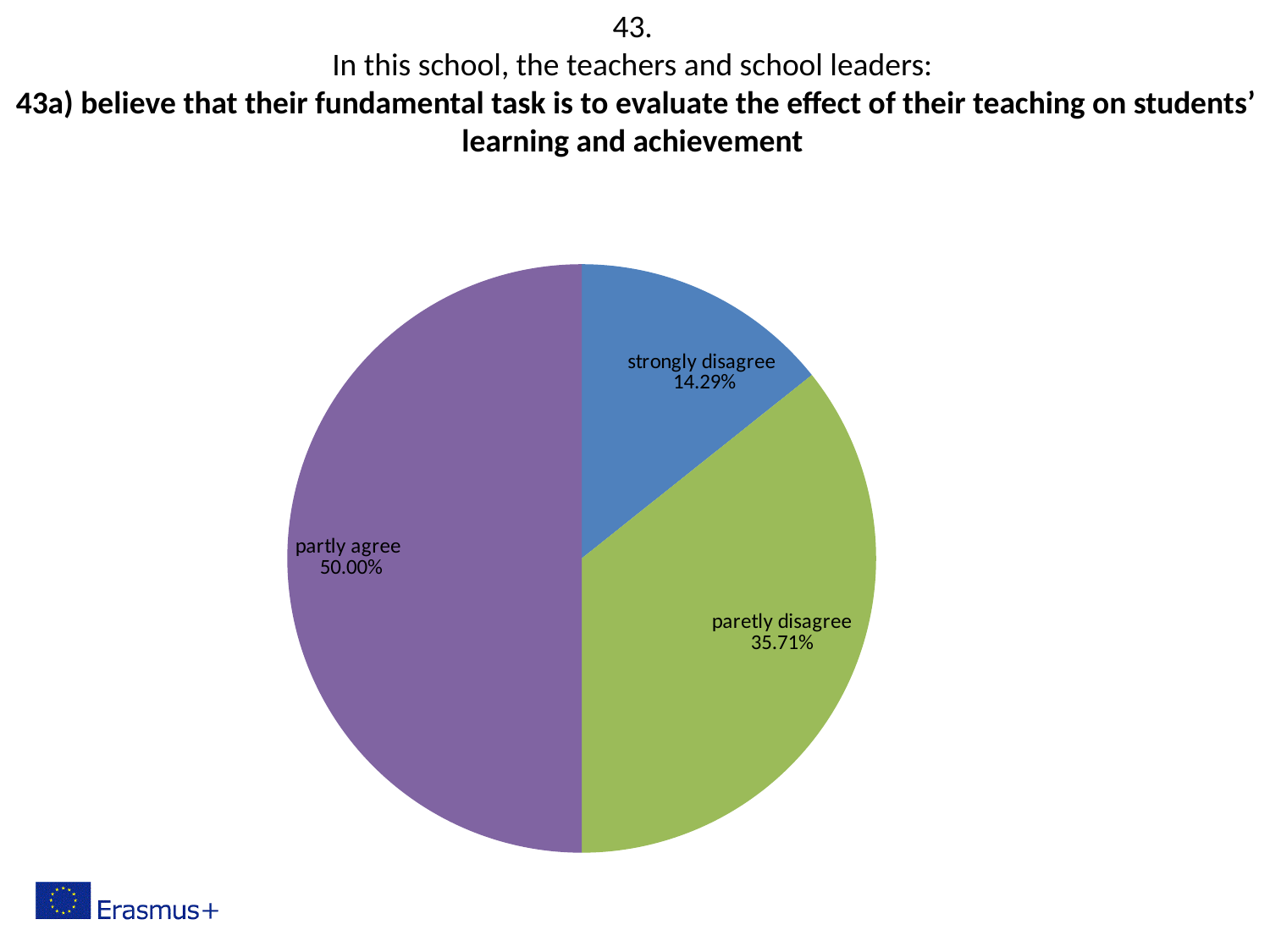
What is the difference in percentage points between 'partly agree' and 'paretly disagree'? 14.29 What colour is the 'partly agree' slice? purple How many slices does the pie chart have? 3 What percentage of respondents chose 'paretly disagree'? 35.71% What is the difference in percentage points between 'paretly disagree' and 'strongly disagree'? 21.42 Which response category has the smallest share of the pie? strongly disagree What kind of chart is shown on the slide? pie chart Which response category has the largest share of the pie? partly agree What percentage of respondents chose 'strongly disagree'? 14.29% Which is larger, the share for 'paretly disagree' or the share for 'strongly disagree'? paretly disagree What percentage of respondents chose 'partly agree'? 50.00% What colour is the 'strongly disagree' slice? blue